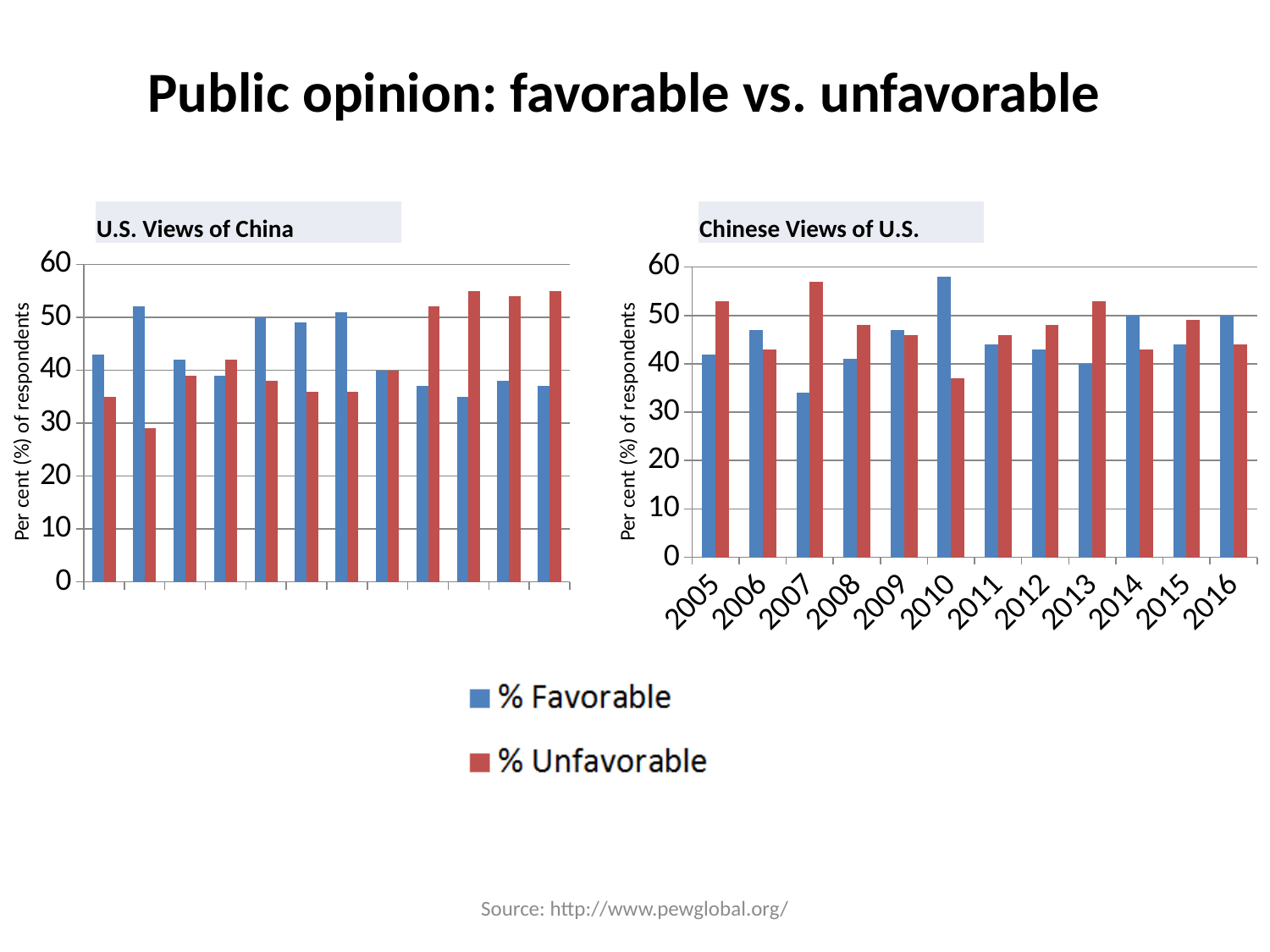
In the "Chinese Views of U.S." chart, which is larger for 2007: % Favorable or % Unfavorable? % Unfavorable In the "Chinese Views of U.S." chart, which is larger for 2010: % Favorable or % Unfavorable? % Favorable What is the label on the vertical axis of the "U.S. Views of China" chart? Per cent (%) of respondents In the "Chinese Views of U.S." chart, which year has the highest % Favorable value? 2010 What kind of chart is the "Chinese Views of U.S." chart? bar chart In the "Chinese Views of U.S." chart, which year has the lowest % Unfavorable value? 2010 How many series does the legend list? 2 In the "Chinese Views of U.S." chart, how many years are shown on the x axis? 12 In the "Chinese Views of U.S." chart, is the % Favorable value for 2007 greater or less than 40? less In the "Chinese Views of U.S." chart, which year has the lowest % Favorable value? 2007 In the "Chinese Views of U.S." chart, is the % Unfavorable value for 2005 greater or less than 50? greater In the "Chinese Views of U.S." chart, is the % Favorable value for 2010 greater or less than 50? greater